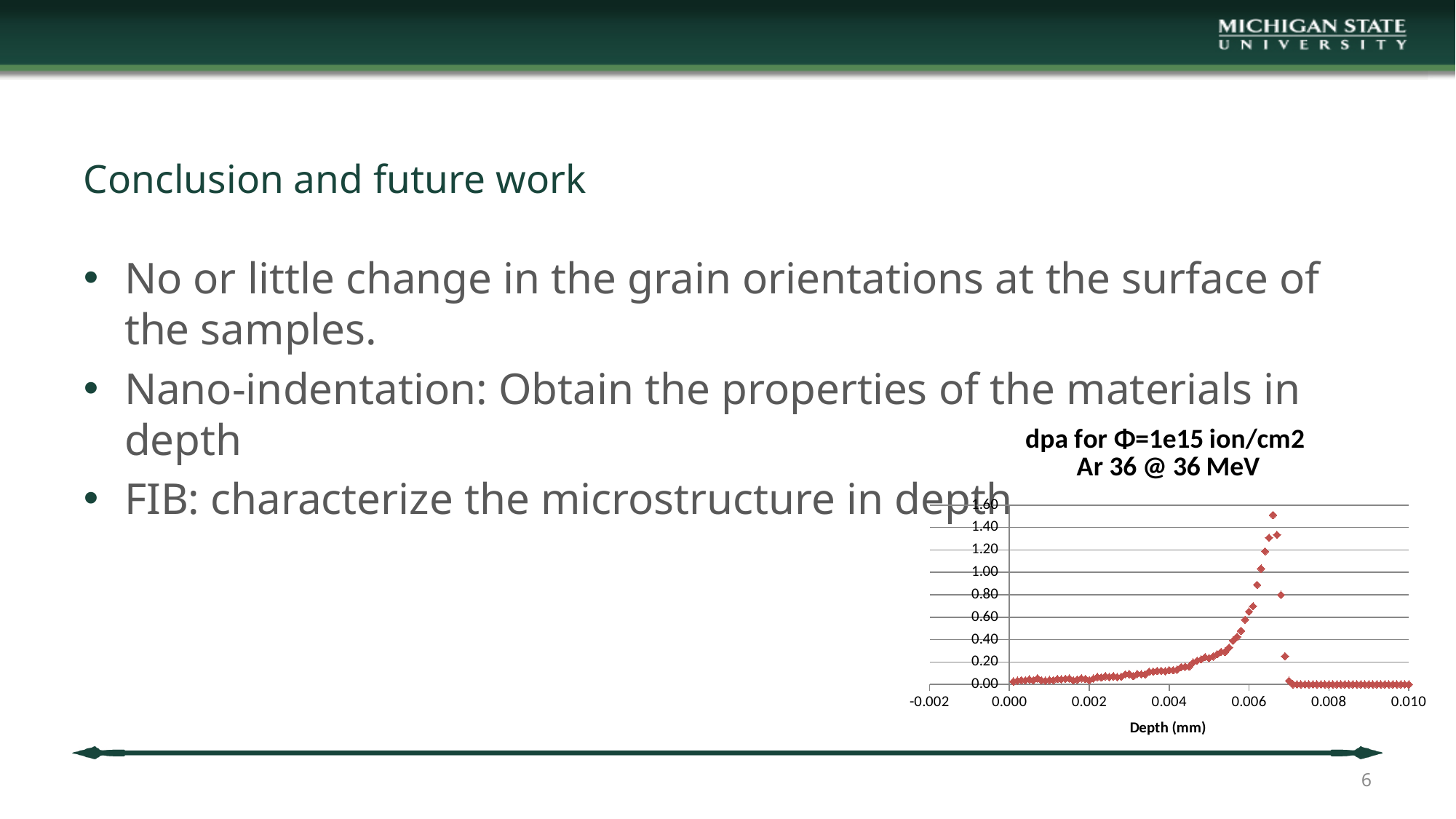
What is the highest tick value shown on the y axis of the chart? 1.60 Is the plotted value at a depth of 0.006 mm greater or less than 0.40? greater Is the plotted value at a depth of 0.008 mm greater or less than 0.20? less What is the label of the x axis of the chart? Depth (mm) Which is larger: the plotted value at a depth of 0.004 mm or at a depth of 0.009 mm? 0.004 mm Is the plotted value at a depth of 0.002 mm greater or less than 0.20? less What kind of chart is shown on the slide? scatter chart Around which depth on the x axis does the plotted dpa reach its peak: near 0.002 mm or near 0.006 mm? near 0.006 mm What is the title of the chart on the slide? dpa for Φ=1e15 ion/cm2 Ar 36 @ 36 MeV How do the plotted values change as depth increases from 0.000 mm to about 0.0065 mm? they rise